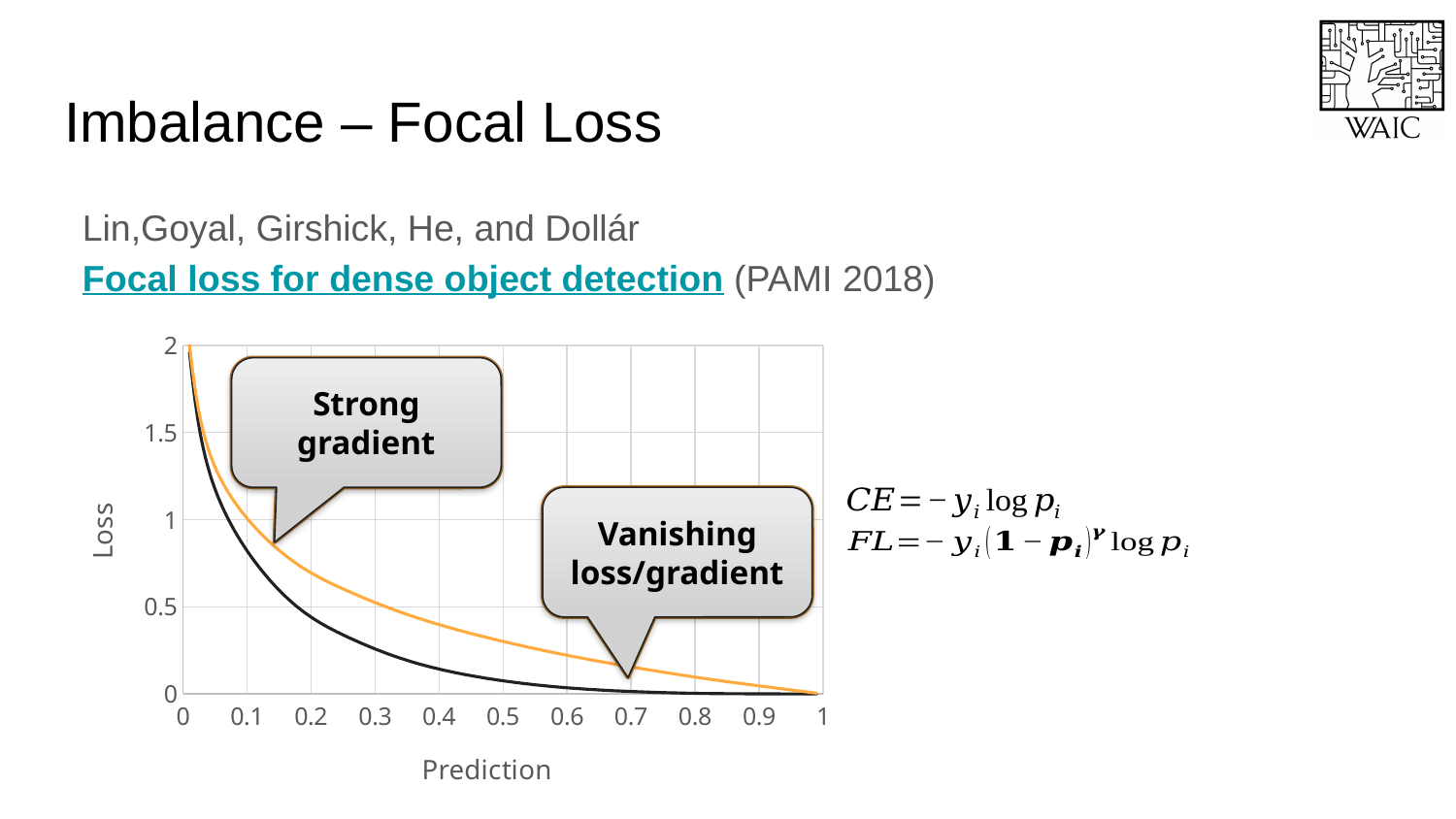
Is the Loss of the orange curve at a Prediction of 0.1 greater or less than 0.5? greater How many curves are plotted on the chart? 2 Is the Loss of the black curve at a Prediction of 0.9 greater or less than 0.5? less What is the maximum value shown on the Loss axis? 2 At a Prediction of 0.5, which curve has the higher Loss, the orange one or the black one? The orange one Is the Loss of the black curve at a Prediction of 0.5 greater or less than 0.5? less What is the label of the x axis? Prediction Do the curves rise or fall as Prediction increases from 0 to 1? Fall What is the label of the y axis? Loss What kind of chart is shown on the slide? Line chart